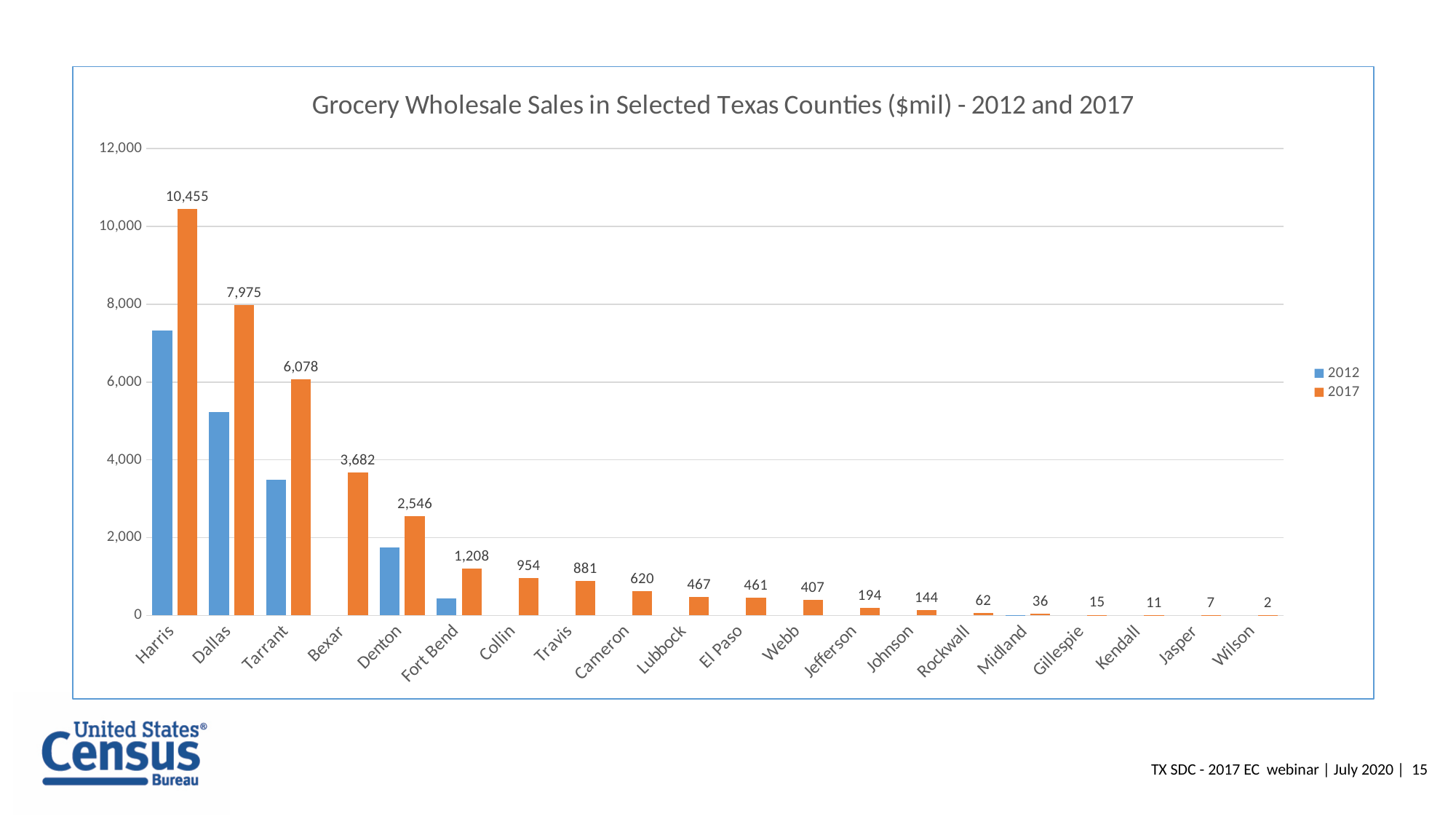
Which county has the highest 2017 value? Harris Is the 2012 value for Harris County greater or less than 6,000? greater Is the 2012 value for Tarrant County greater or less than 4,000? less Which is larger, the 2017 value for Lubbock or the 2017 value for El Paso? Lubbock What is the 2017 value shown for Bexar County? 3,682 How many counties are shown on the x axis? 20 What is the difference between the 2017 values for Dallas and Tarrant counties? 1,897 Which county has the lowest 2017 value? Wilson What is the 2017 grocery wholesale sales value for Harris County? 10,455 What is the 2017 value shown for Cameron County? 620 How many series does the legend list? 2 What kind of chart is shown on the slide? Bar chart